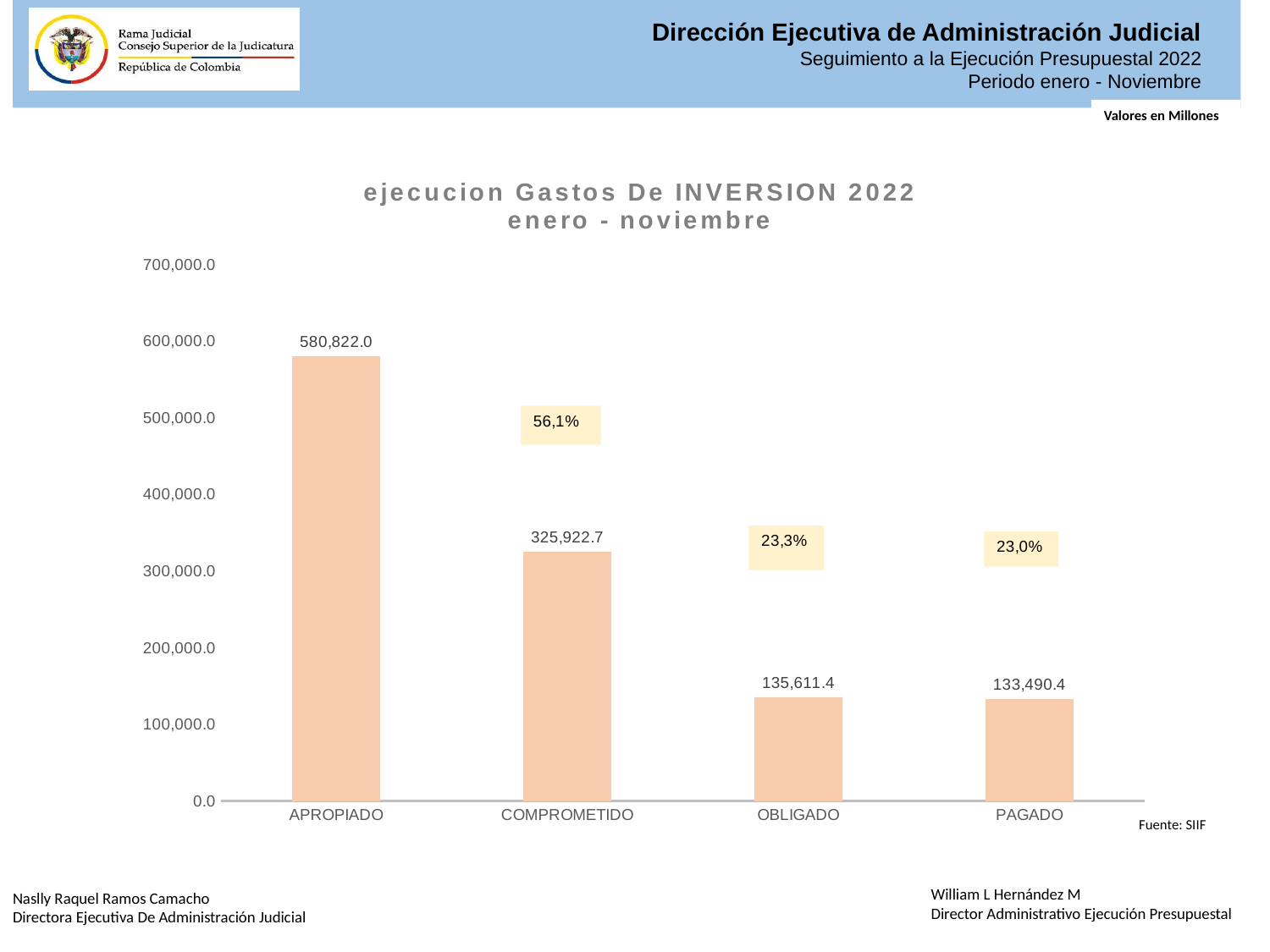
How many categories are shown on the x axis? 4 Which category has the highest value? APROPIADO What is the value for PAGADO? 133,490.4 What is the value for COMPROMETIDO? 325,922.7 What is the value for OBLIGADO? 135,611.4 What is the difference between the values for APROPIADO and COMPROMETIDO? 254,899.3 What kind of chart is shown on the slide? Bar chart Which is larger, the value for COMPROMETIDO or the value for OBLIGADO? COMPROMETIDO What is the value for APROPIADO? 580,822.0 Which category has the lowest value? PAGADO What is the difference between the values for OBLIGADO and PAGADO? 2,121.0 What percentage label is shown above the COMPROMETIDO bar? 56,1%